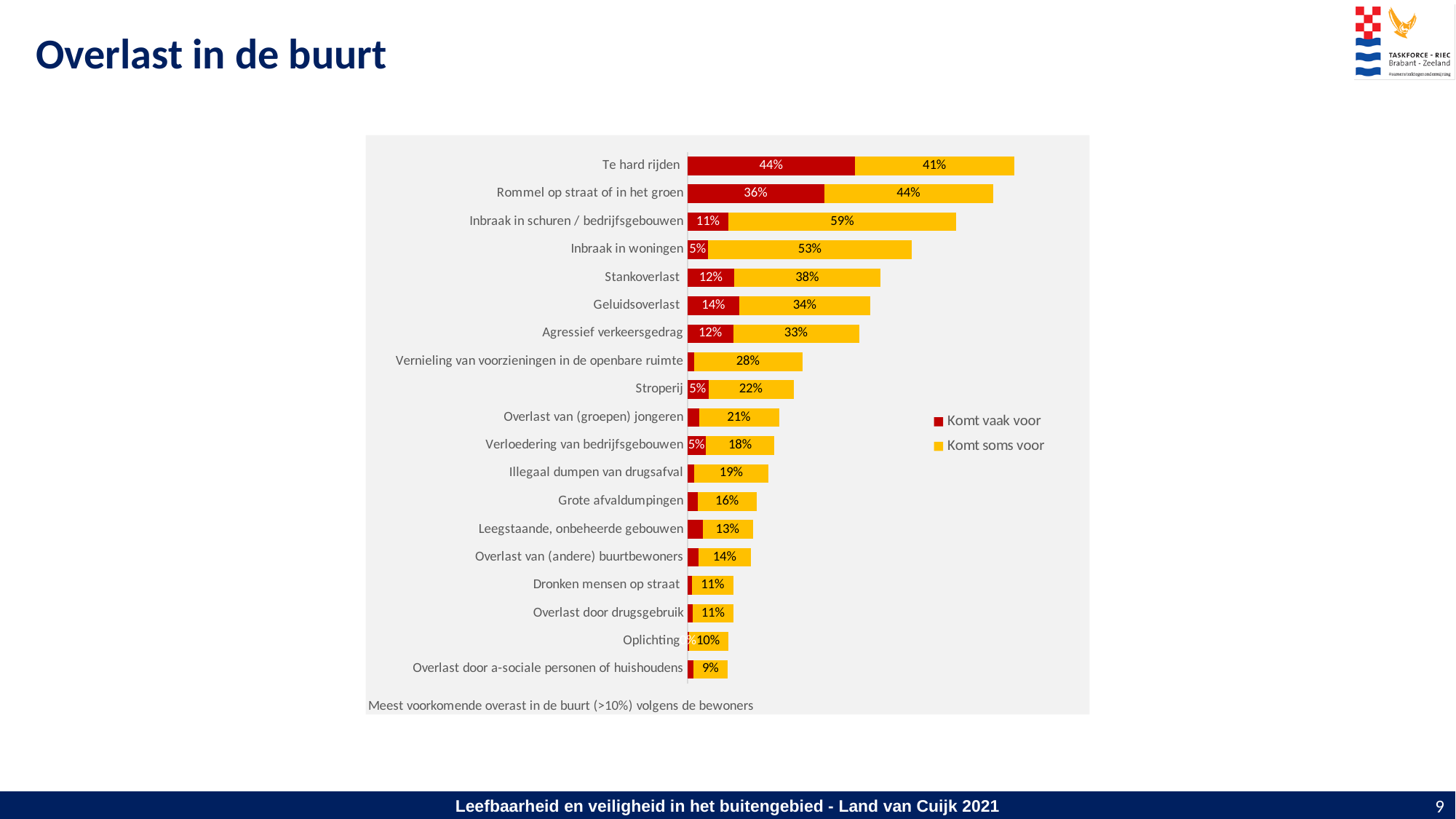
How many series does the legend list? 2 Which is larger: the 'Komt vaak voor' value for 'Geluidsoverlast' or for 'Stankoverlast'? Geluidsoverlast What kind of chart is shown on the slide? Stacked bar chart Which category has the lowest 'Komt soms voor' value? Overlast door a-sociale personen of huishoudens How many categories are shown in the chart? 19 What is the difference between the 'Komt vaak voor' values for 'Te hard rijden' and 'Rommel op straat of in het groen'? 8 percentage points Which category has the highest 'Komt soms voor' value? Inbraak in schuren / bedrijfsgebouwen Which category has the highest 'Komt vaak voor' value? Te hard rijden What percentage of residents say 'Te hard rijden' 'Komt vaak voor'? 44% What is the 'Komt soms voor' value for 'Inbraak in schuren / bedrijfsgebouwen'? 59% What is the 'Komt soms voor' value for 'Stroperij'? 22% What is the combined total of the two segments for 'Te hard rijden'? 85%